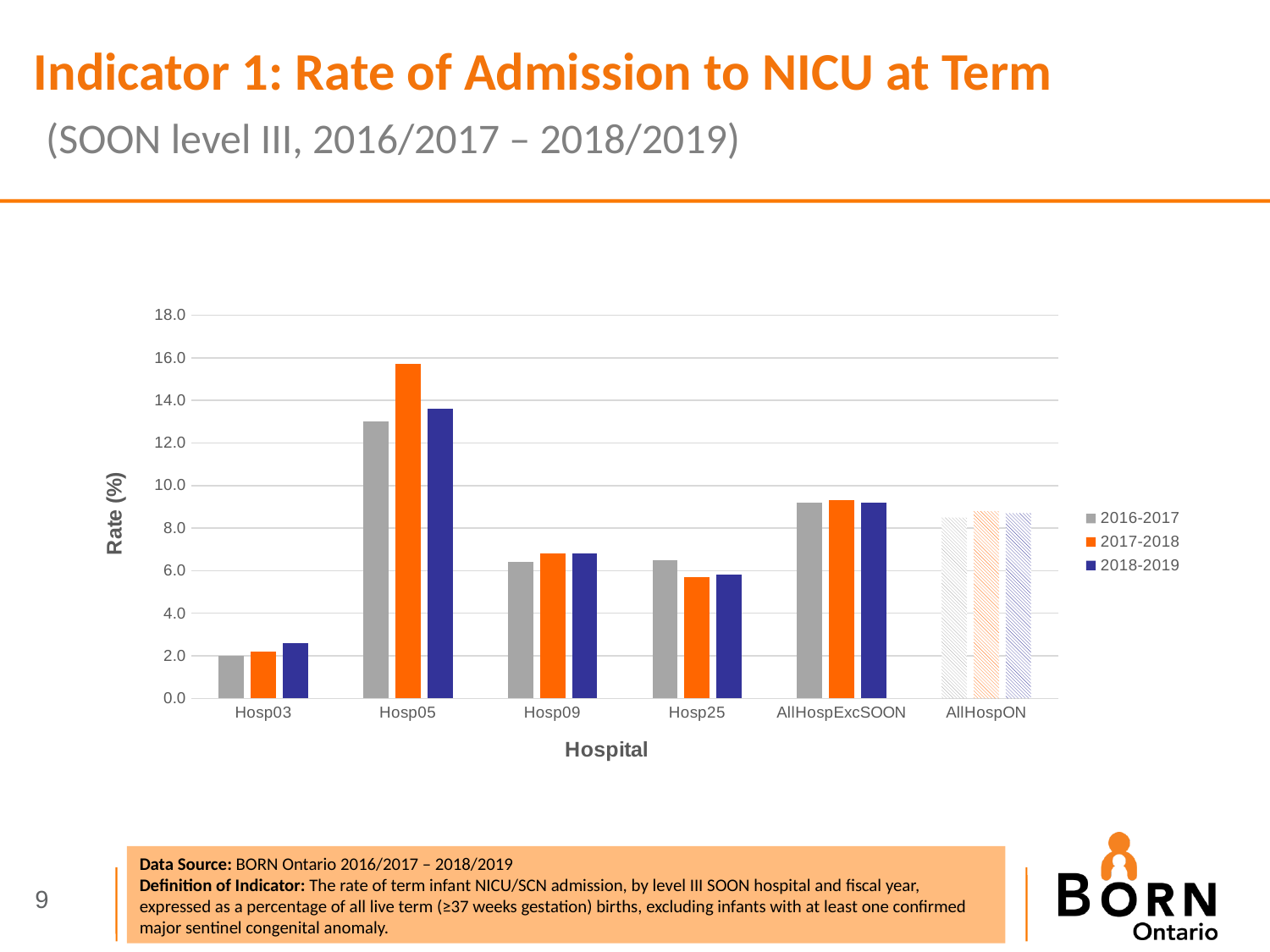
Is the 2018-2019 value for Hosp03 greater or less than 4.0? less For Hosp25, which is larger: the 2016-2017 value or the 2017-2018 value? 2016-2017 What is the title of the y axis? Rate (%) For Hosp05, which is larger: the 2016-2017 value or the 2017-2018 value? 2017-2018 How many series does the legend list? 3 Is the 2016-2017 value for AllHospExcSOON greater or less than 8.0? greater How many hospital categories are shown on the x axis? 6 Do the values for Hosp03 rise or fall from 2016-2017 to 2018-2019? rise Is the 2017-2018 value for Hosp05 greater or less than 14.0? greater Which hospital has the lowest rate for 2016-2017? Hosp03 Which hospital has the highest rate for 2017-2018? Hosp05 What kind of chart is shown on the slide? bar chart